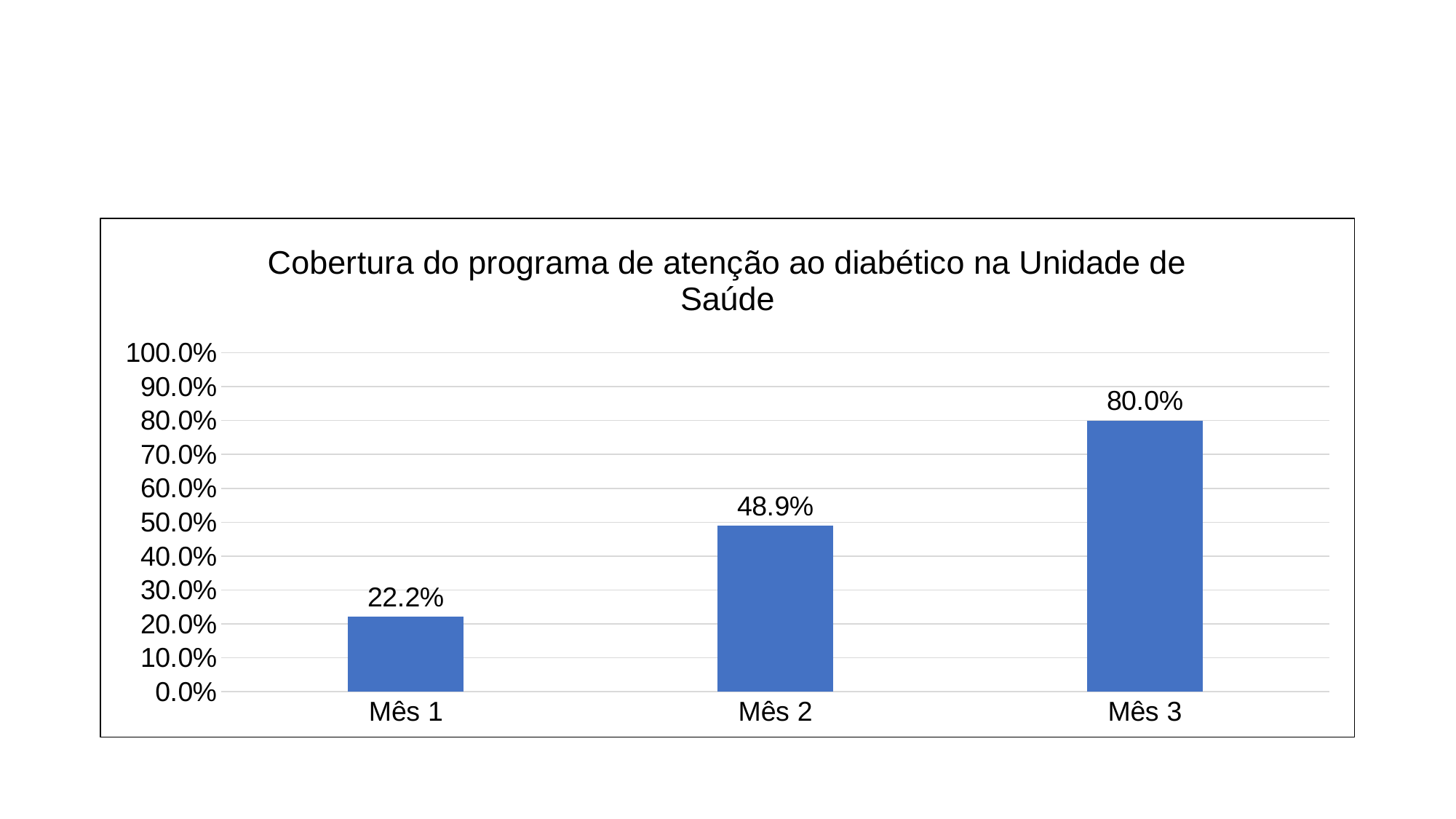
What is the value for Mês 3? 80.0% Which month has the highest coverage? Mês 3 What is the value for Mês 1? 22.2% Which month has the lowest coverage? Mês 1 What kind of chart is shown on the slide? bar chart Do the values rise or fall from Mês 1 to Mês 3? rise How many categories are shown on the x axis? 3 What is the difference between the values for Mês 2 and Mês 1? 26.7% Which is larger, the value for Mês 2 or the value for Mês 3? Mês 3 Is the value for Mês 2 greater or less than 50.0%? less What is the value for Mês 2? 48.9% What is the difference between the values for Mês 3 and Mês 1? 57.8%